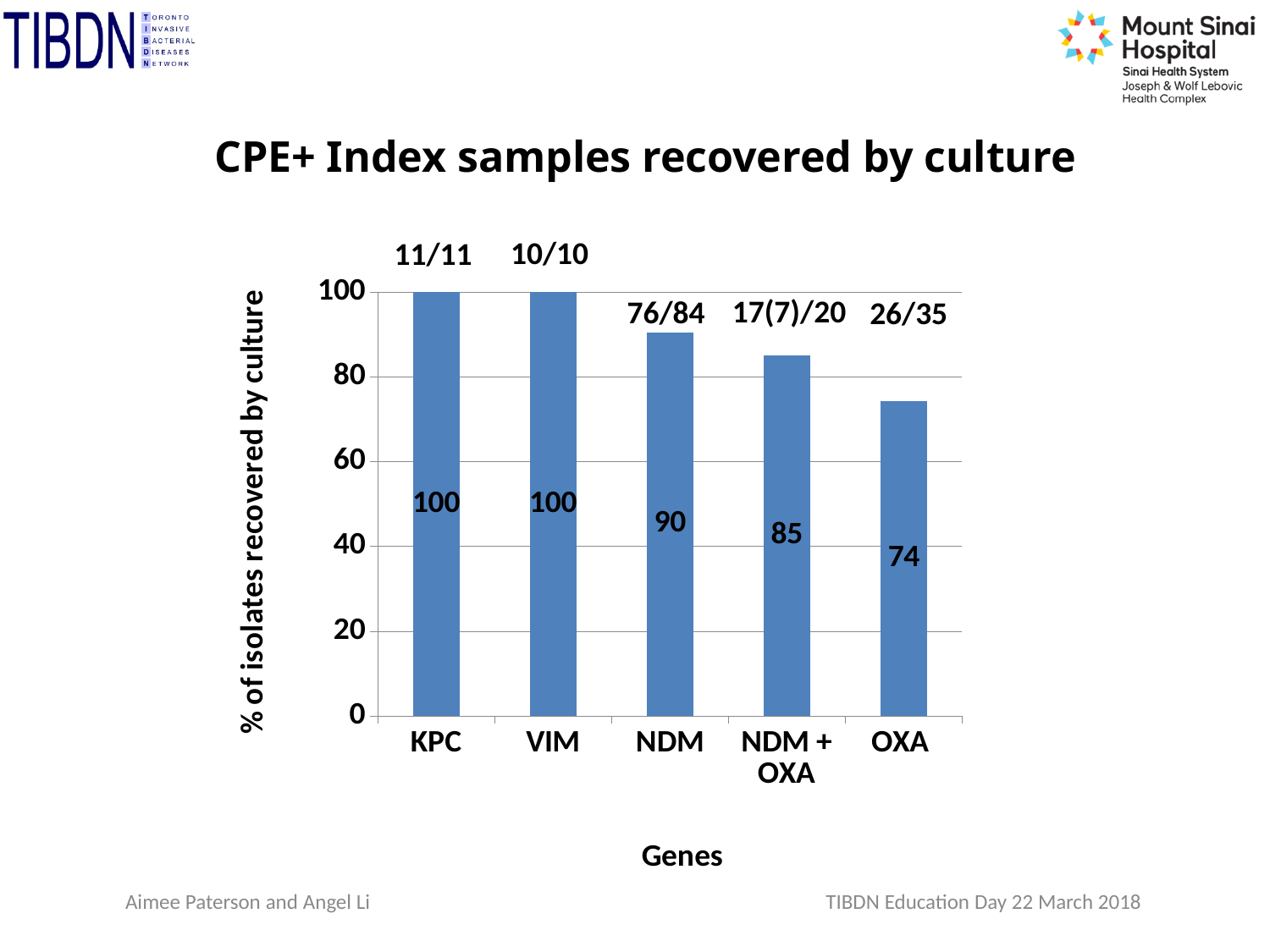
What is the value for NDM? 90 Do the values rise or fall from KPC to OXA along the x axis? fall What is the value for NDM + OXA? 85 What is the label of the y axis? % of isolates recovered by culture What is the value for OXA? 74 What kind of chart is shown on the slide? bar chart Which gene has the lowest % of isolates recovered by culture? OXA How many genes are shown on the x axis? 5 What is the title of the chart? CPE+ Index samples recovered by culture Which is larger, the value for NDM or the value for NDM + OXA? NDM What is the difference between the values for NDM and OXA? 16 Is the value for OXA greater or less than 80? less